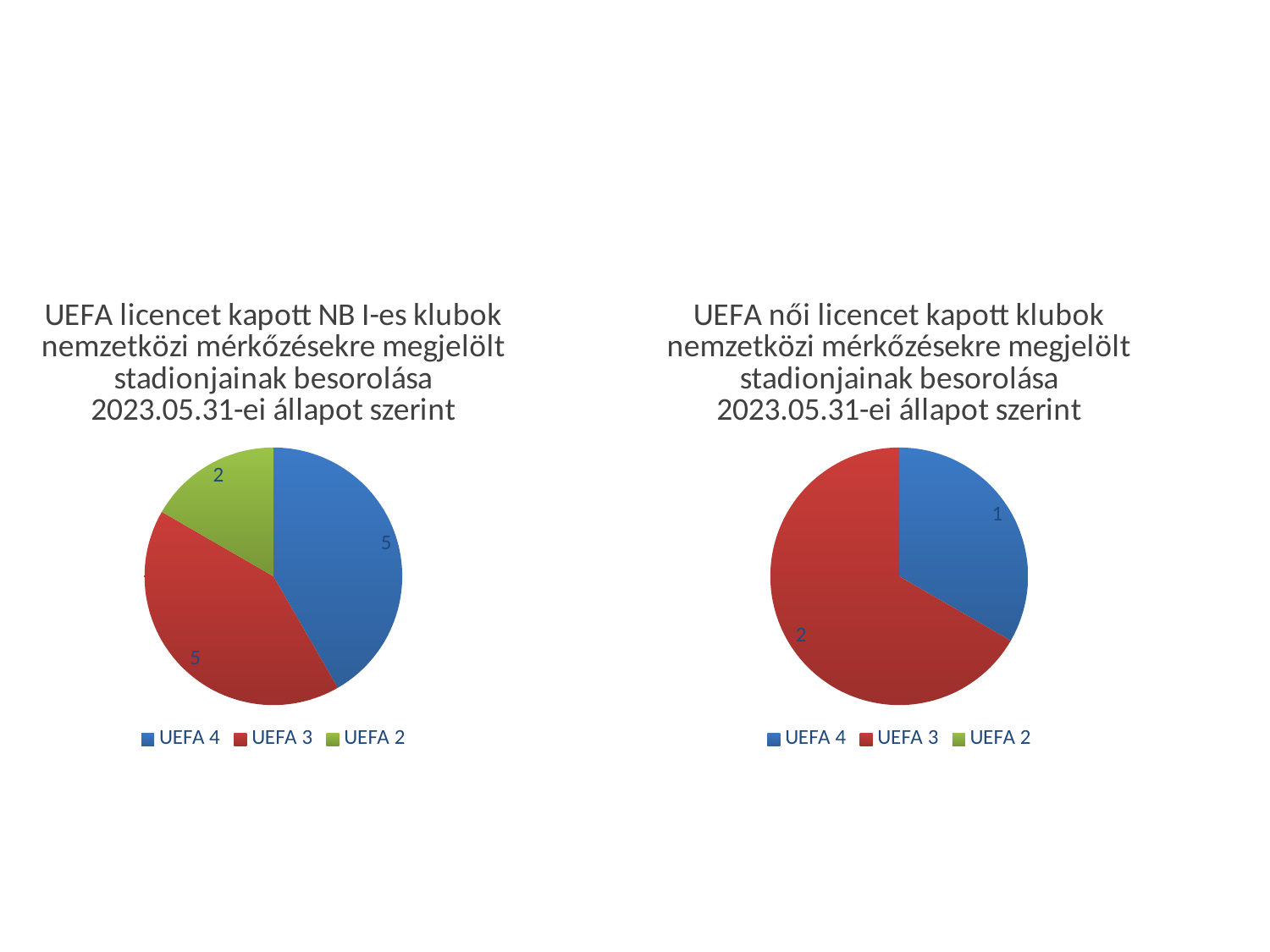
What kind of chart is the left chart (UEFA licencet kapott NB I-es klubok)? Pie chart In the left chart (UEFA licencet kapott NB I-es klubok), which colour represents UEFA 3? Red How many entries does the legend of the right chart (UEFA női licencet kapott klubok) list? 3 In the left chart (UEFA licencet kapott NB I-es klubok), what is the value for UEFA 4? 5 In the left chart (UEFA licencet kapott NB I-es klubok), what is the value for UEFA 2? 2 In the right chart (UEFA női licencet kapott klubok), what is the value for UEFA 4? 1 In the right chart (UEFA női licencet kapott klubok), which category has the largest slice? UEFA 3 In the left chart (UEFA licencet kapott NB I-es klubok), which category has the smallest slice? UEFA 2 In the left chart (UEFA licencet kapott NB I-es klubok), what is the total of all the slice values? 12 In the right chart (UEFA női licencet kapott klubok), which is larger, UEFA 3 or UEFA 4? UEFA 3 In the right chart (UEFA női licencet kapott klubok), what is the value for UEFA 3? 2 In the left chart (UEFA licencet kapott NB I-es klubok), what is the difference between the UEFA 4 value and the UEFA 2 value? 3